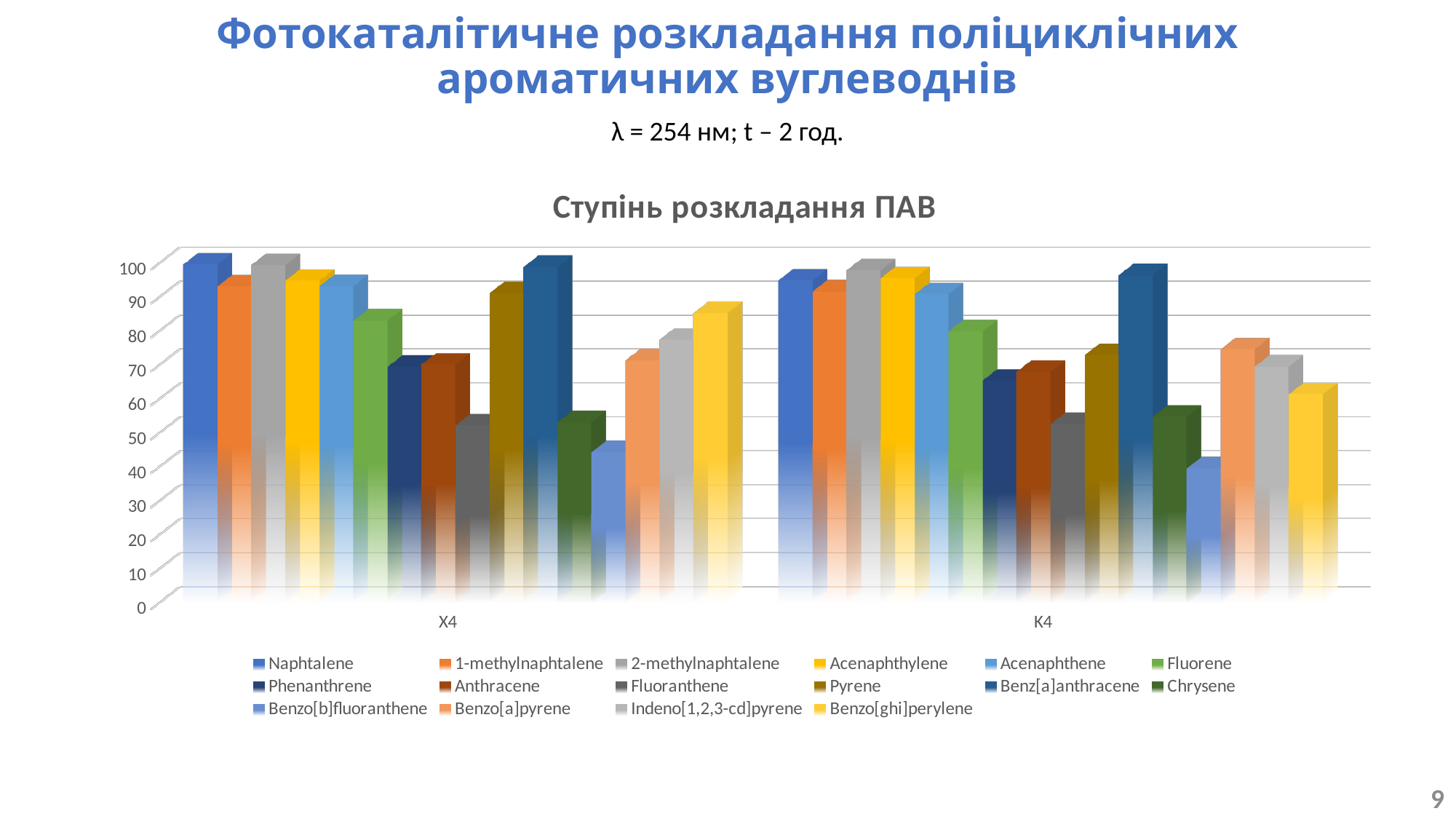
Is the value for Naphtalene in category X4 greater or less than 90? greater Is the value for Benz[a]anthracene in category K4 greater or less than 90? greater What are the two category labels on the x axis? X4 and K4 Which series has the lowest value in category K4? Benzo[b]fluoranthene Is the value for Benzo[b]fluoranthene in category X4 greater or less than 60? less What is the title of the chart? Ступінь розкладання ПАВ What kind of chart is shown on the slide? bar chart How many series does the chart legend list? 16 Which is larger in category X4: the value for Pyrene or the value for Fluoranthene? Pyrene How many categories are shown on the x axis of the chart? 2